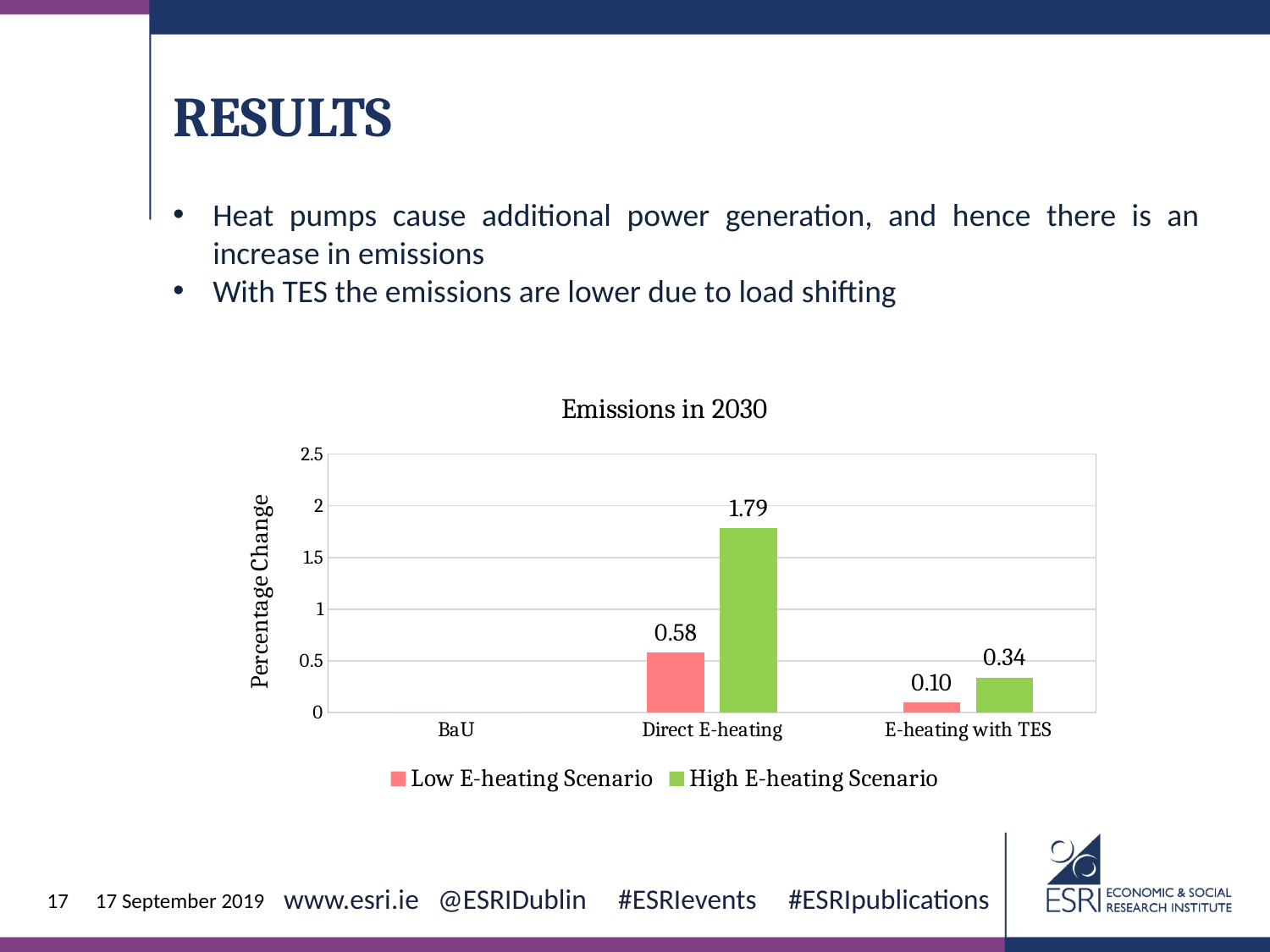
How many categories are shown on the x axis? 3 What is the value for E-heating with TES in the High E-heating Scenario? 0.34 What is the difference between the High E-heating Scenario values for Direct E-heating and E-heating with TES? 1.45 Which category has the highest value in the High E-heating Scenario? Direct E-heating What is the difference between the High and Low E-heating Scenario values for Direct E-heating? 1.21 Which is larger: the Low E-heating Scenario value for Direct E-heating or the High E-heating Scenario value for E-heating with TES? Low E-heating Scenario value for Direct E-heating What is the value for Direct E-heating in the Low E-heating Scenario? 0.58 What is the title of the chart? Emissions in 2030 How many series does the legend list? 2 What is the value for Direct E-heating in the High E-heating Scenario? 1.79 What is the value for E-heating with TES in the Low E-heating Scenario? 0.10 What kind of chart is shown? Bar chart